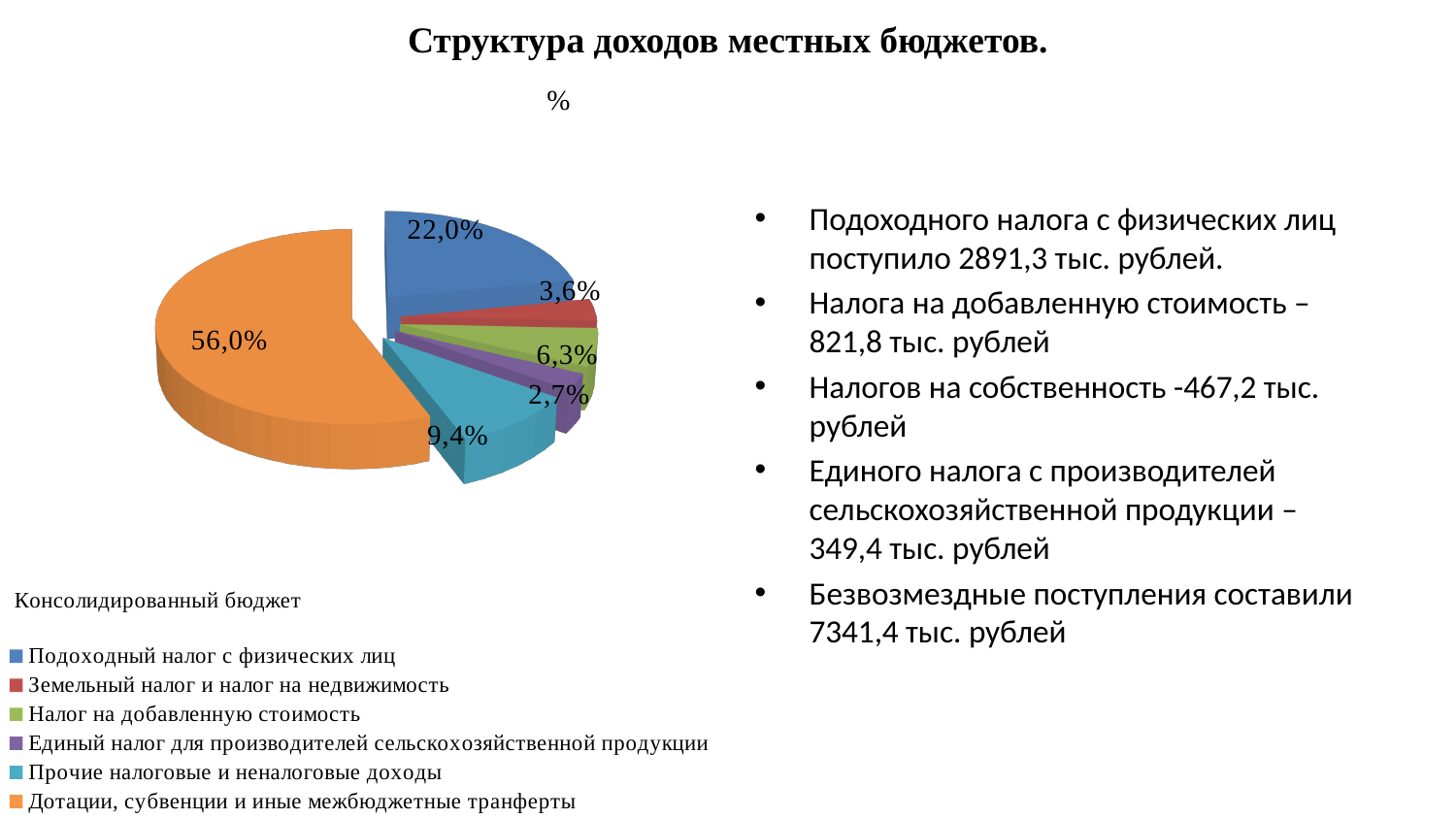
Which is larger: the slice for "Прочие налоговые и неналоговые доходы" or the slice for "Налог на добавленную стоимость"? Прочие налоговые и неналоговые доходы What share of the pie does "Прочие налоговые и неналоговые доходы" have? 9,4% What share of the pie does "Налог на добавленную стоимость" have? 6,3% What kind of chart is shown on the slide? pie chart How many categories does the legend of the pie chart list? 6 What colour is the slice for "Единый налог для производителей сельскохозяйственной продукции"? purple What share of the pie does "Земельный налог и налог на недвижимость" have? 3,6% Which category has the smallest slice of the pie? Единый налог для производителей сельскохозяйственной продукции What share of the pie does "Подоходный налог с физических лиц" have? 22,0% Which category has the largest slice of the pie? Дотации, субвенции и иные межбюджетные трансферты What is the difference in percentage points between the "Дотации, субвенции и иные межбюджетные трансферты" slice and the "Подоходный налог с физических лиц" slice? 34,0 What share of the pie does "Дотации, субвенции и иные межбюджетные трансферты" have? 56,0%